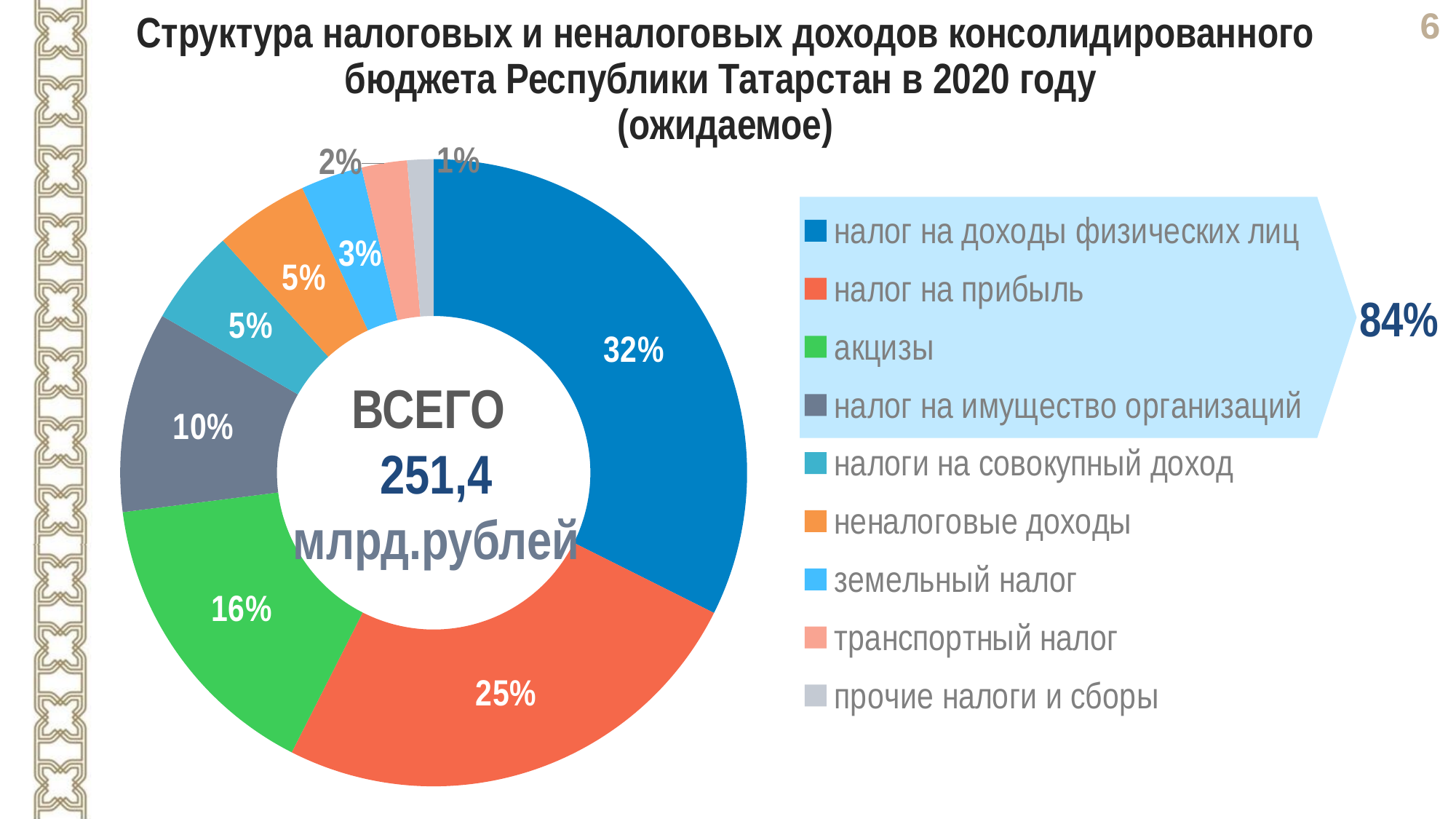
What total value is printed in the centre of the chart? 251,4 млрд.рублей Which is larger: the share for акцизы or the share for налог на имущество организаций? акцизы What percentage is shown for налог на прибыль? 25% What share of the doughnut chart does налог на доходы физических лиц account for? 32% Which category has the smallest share of the chart? прочие налоги и сборы What percentage is shown for налог на имущество организаций? 10% How many categories does the legend list? 9 What percentage is shown for акцизы? 16% Which category has the largest share of the chart? налог на доходы физических лиц What type of chart is shown on the slide? doughnut chart What percentage is shown for земельный налог? 3% What is the difference in percentage points between налог на доходы физических лиц and налог на прибыль? 7